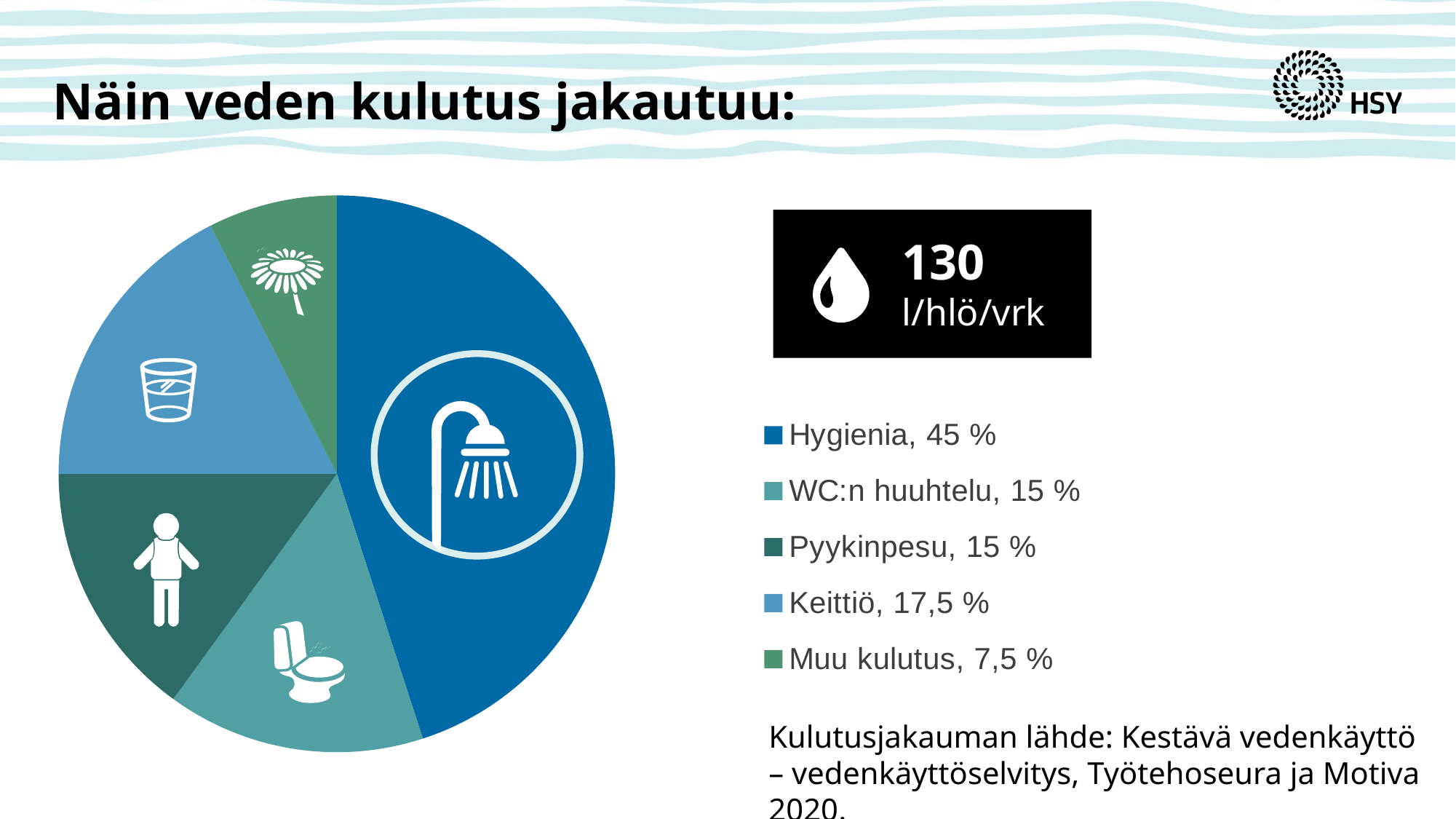
What is the combined share of WC:n huuhtelu and Pyykinpesu? 30 % What percentage is shown for Keittiö? 17,5 % How many categories does the pie chart have? 5 What is the title of the slide containing the pie chart? Näin veden kulutus jakautuu: What is the difference in percentage points between Hygienia and Keittiö? 27,5 % What percentage is shown for WC:n huuhtelu? 15 % Which category has the smallest share of the pie? Muu kulutus Which category has the largest share of the pie? Hygienia What percentage is shown for Muu kulutus? 7,5 % What kind of chart is shown on the slide? pie chart What share of water consumption does Hygienia account for? 45 % Which is larger, the share for Keittiö or the share for Pyykinpesu? Keittiö